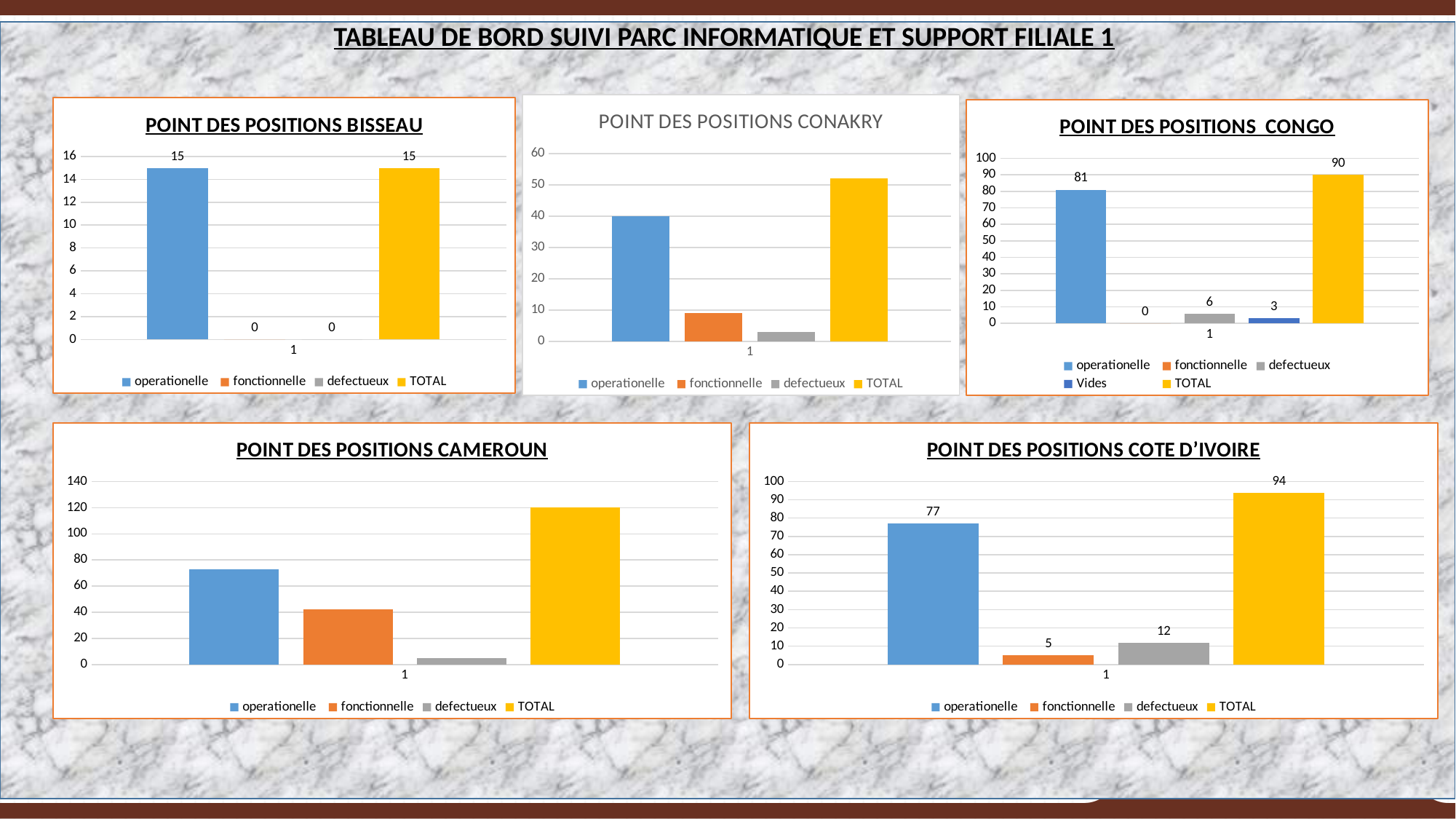
In the POINT DES POSITIONS CAMEROUN chart, which series has the lowest value? defectueux In the POINT DES POSITIONS CONGO chart, what is the value for operationelle? 81 In the POINT DES POSITIONS CONGO chart, what is the value for defectueux? 6 How many charts are shown on the slide? 5 In the POINT DES POSITIONS CONAKRY chart, is the value for operationelle greater or less than 30? greater In the POINT DES POSITIONS BISSEAU chart, what is the value for operationelle? 15 In the POINT DES POSITIONS COTE D'IVOIRE chart, what is the TOTAL value? 94 In the POINT DES POSITIONS CONGO chart, how many series does the legend list? 5 In the POINT DES POSITIONS COTE D'IVOIRE chart, what is the difference between operationelle and defectueux? 65 What kind of chart is POINT DES POSITIONS CONAKRY? bar chart In the POINT DES POSITIONS COTE D'IVOIRE chart, which is larger, fonctionnelle or defectueux? defectueux In the POINT DES POSITIONS CAMEROUN chart, is the value for fonctionnelle greater or less than 60? less